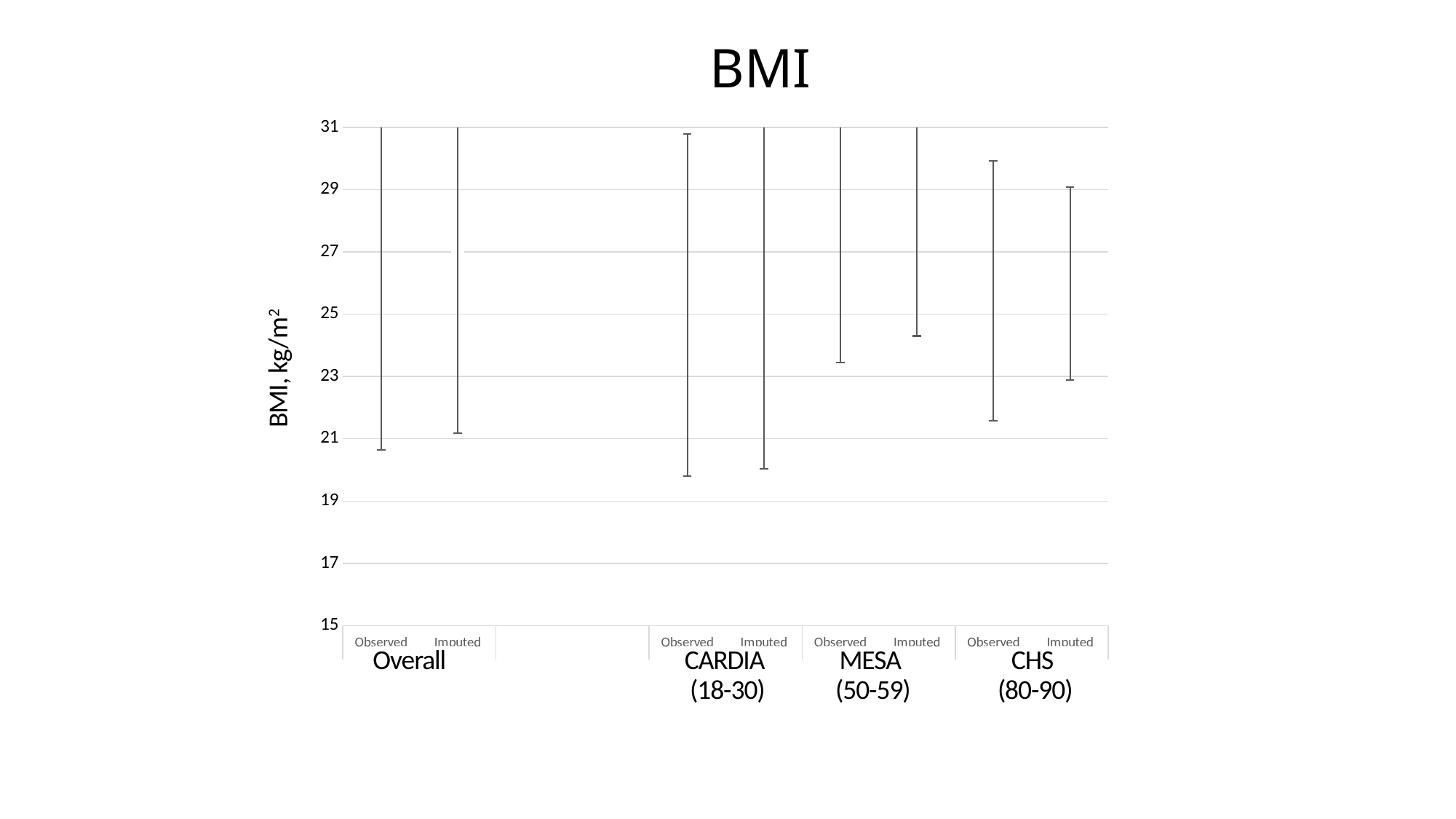
What is the label on the vertical axis? BMI, kg/m² Is the upper end of the CHS Imputed range greater or less than 31? less What is the title of the chart? BMI Which cohort group has the lowest upper ends of its ranges? CHS (80-90) Is the lower end of the MESA Observed range greater or less than 23? greater How many cohort groups are shown along the x axis? 4 Is the lower end of the MESA Imputed range greater or less than 23? greater Which has the higher lower end: the MESA Observed range or the CARDIA Observed range? MESA Observed How many vertical range bars are plotted in total? 8 Which cohort group has the highest lower ends of its ranges? MESA (50-59)